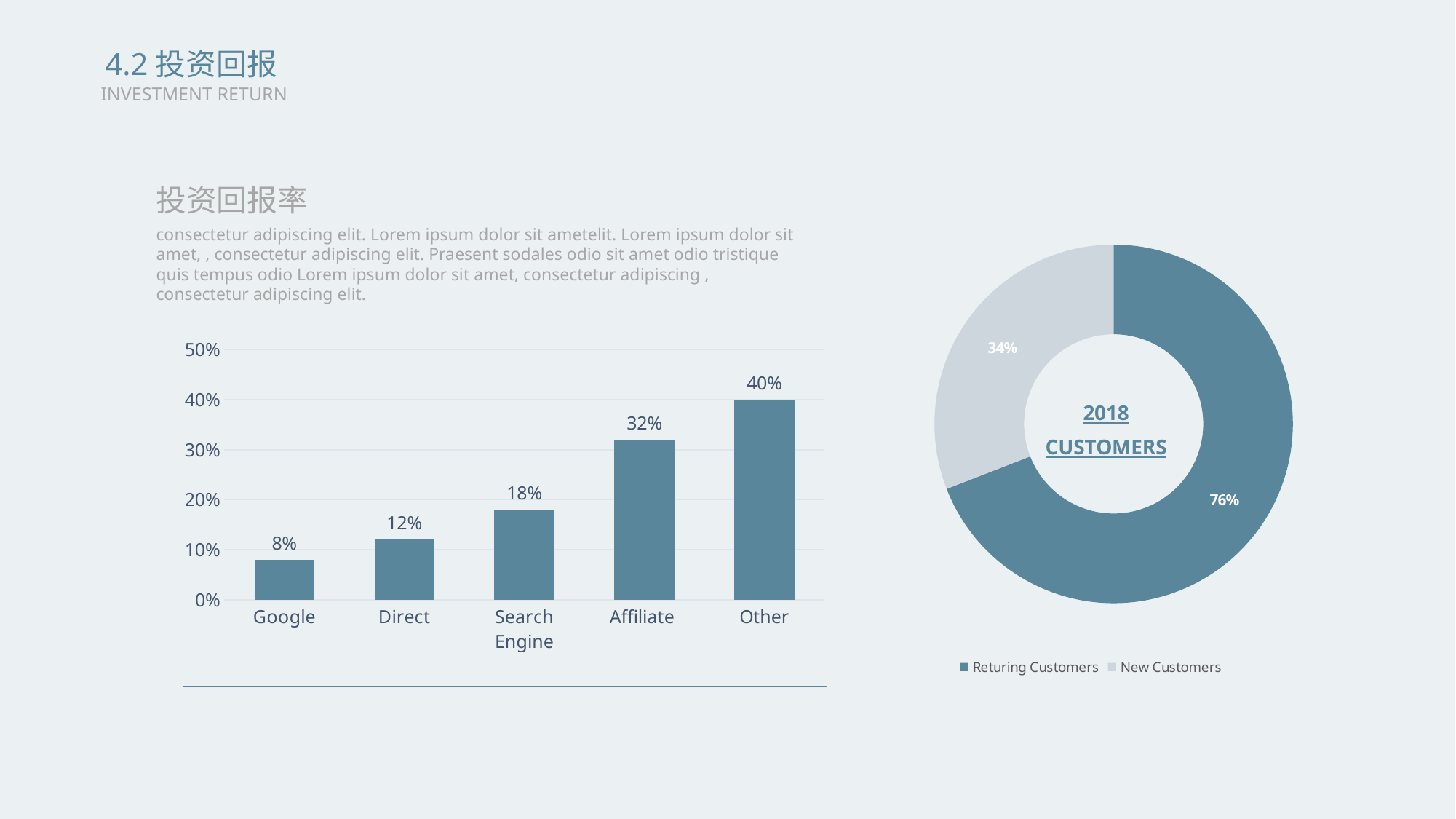
In the 2018 Customers donut chart on the right, what share is Returing Customers? 76% How many entries does the legend of the 2018 Customers chart on the right list? 2 In the bar chart on the left, what is the value for Google? 8% In the bar chart on the left, do the values rise or fall from Google to Other? Rise In the bar chart on the left, what is the value for Affiliate? 32% In the bar chart on the left, which category has the lowest value? Google In the 2018 Customers donut chart on the right, what share is New Customers? 34% In the bar chart on the left, which category has the highest value? Other In the bar chart on the left, which is larger, the value for Direct or the value for Search Engine? Search Engine What kind of chart is the chart on the left? Bar chart How many categories are shown in the bar chart on the left? 5 In the bar chart on the left, what is the difference between the values for Other and Search Engine? 22%